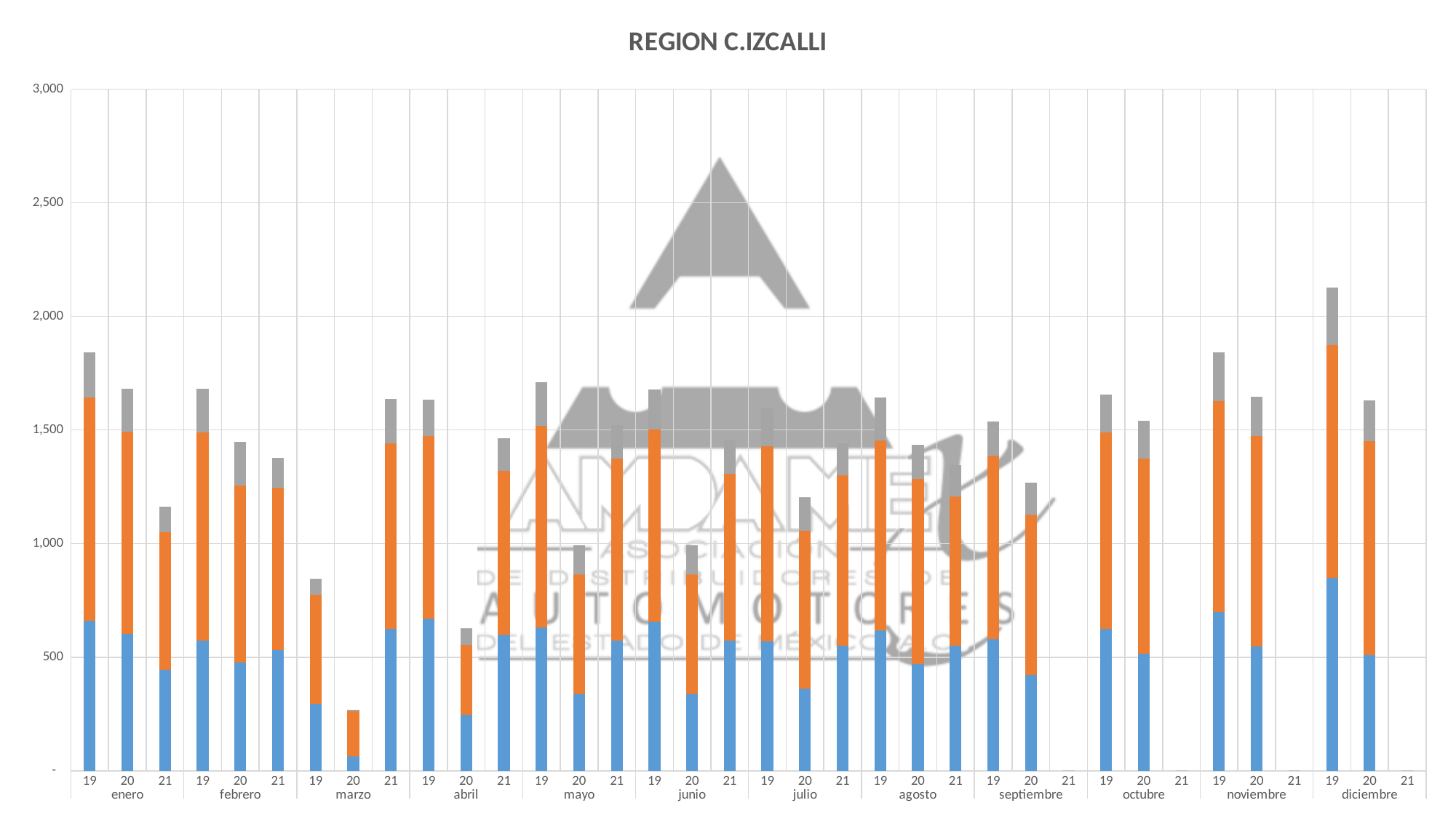
Is the total for marzo 20 greater or less than 500? less Is the total for diciembre 19 greater or less than 2,000? greater What is the title of the chart? REGION C.IZCALLI Which bar has the highest total in the chart? diciembre 19 Which bar is taller, marzo 19 or marzo 20? marzo 19 In enero, do the bar totals rise or fall from 19 to 21? fall Is the total for abril 20 greater or less than 1,000? less Which bar has the lowest total in the chart? marzo 20 Which bar is taller, enero 19 or enero 21? enero 19 How many months are shown along the x axis of the chart? 12 What kind of chart is shown on the slide? Stacked bar chart